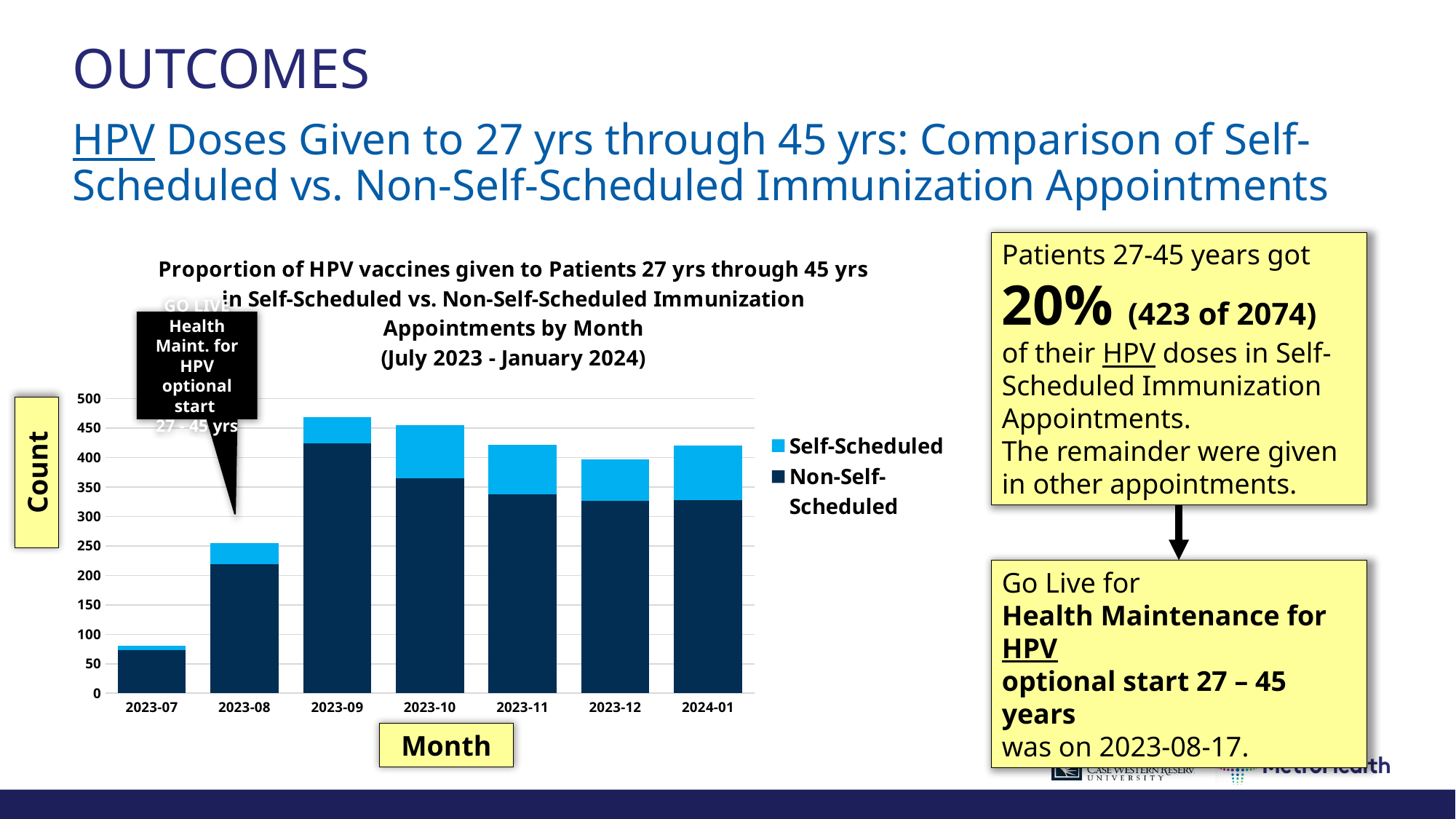
Which series is shown in the lighter blue colour in the chart? Self-Scheduled Do the total counts rise or fall from 2023-07 to 2023-09? rise Which month has a larger total count, 2023-07 or 2023-09? 2023-09 Is the Non-Self-Scheduled count for 2023-09 greater or less than 400? greater Which month has the lowest total count of HPV doses in the chart? 2023-07 How many series does the chart legend list? 2 Is the total count for 2023-08 greater or less than 200? greater Is the total count for 2023-07 greater or less than 100? less What kind of chart is shown on the slide? Stacked bar chart Which month has the highest total count of HPV doses in the chart? 2023-09 How many months are shown on the x axis of the chart? 7